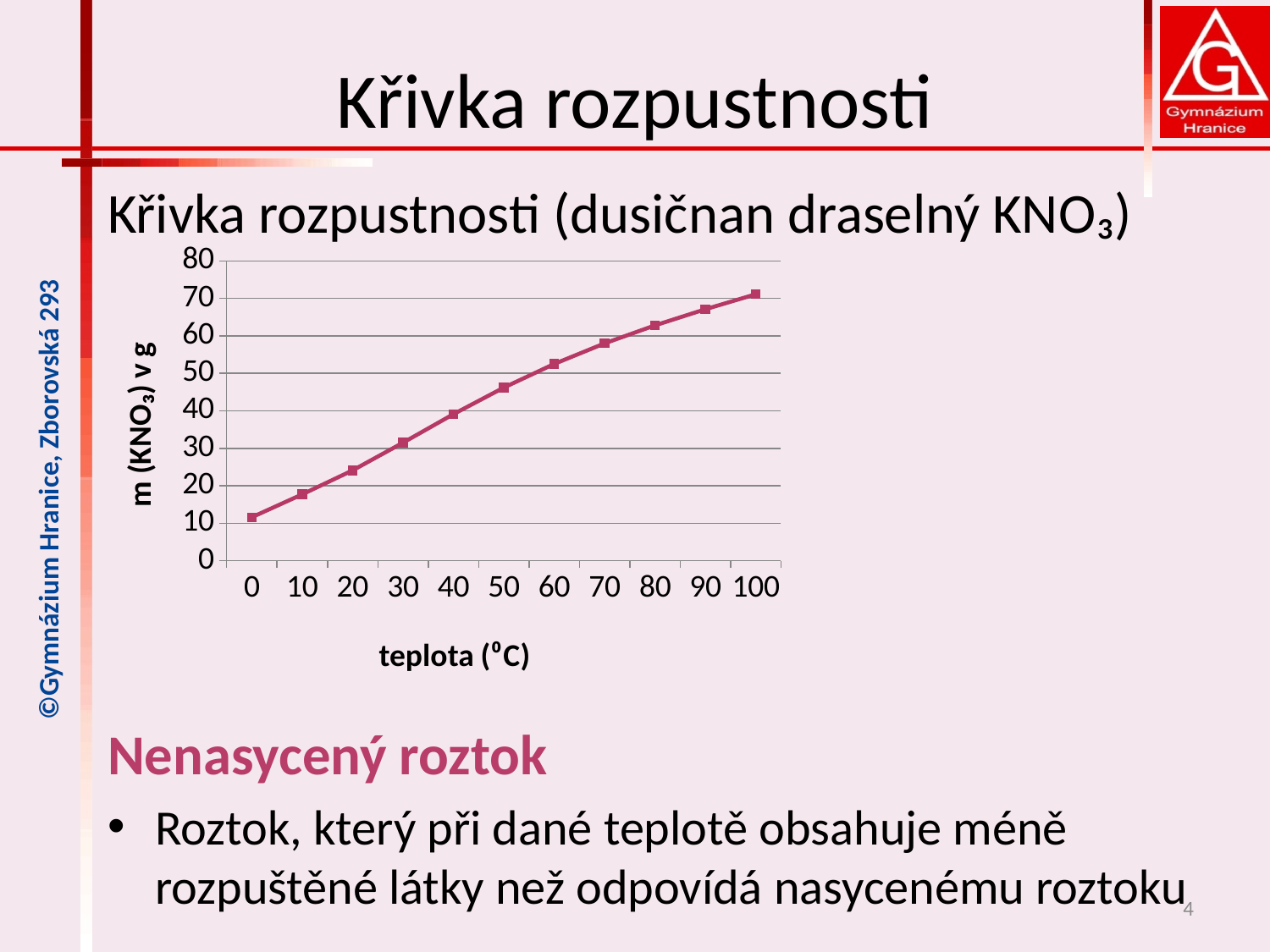
Do the values rise or fall as temperature increases along the x axis? rise How many data points are plotted on the solubility curve? 11 Which is larger, the value at 40 °C or the value at 70 °C? 70 °C Is the value at 50 °C greater or less than 40? greater At which temperature is the plotted value highest? 100 What is the title of the x axis? teplota (⁰C) At which temperature is the plotted value lowest? 0 What kind of chart is shown on the slide? line chart Is the value at 0 °C greater or less than 20? less What is the title of the y axis? m (KNO₃) v g Is the value at 30 °C greater or less than 40? less